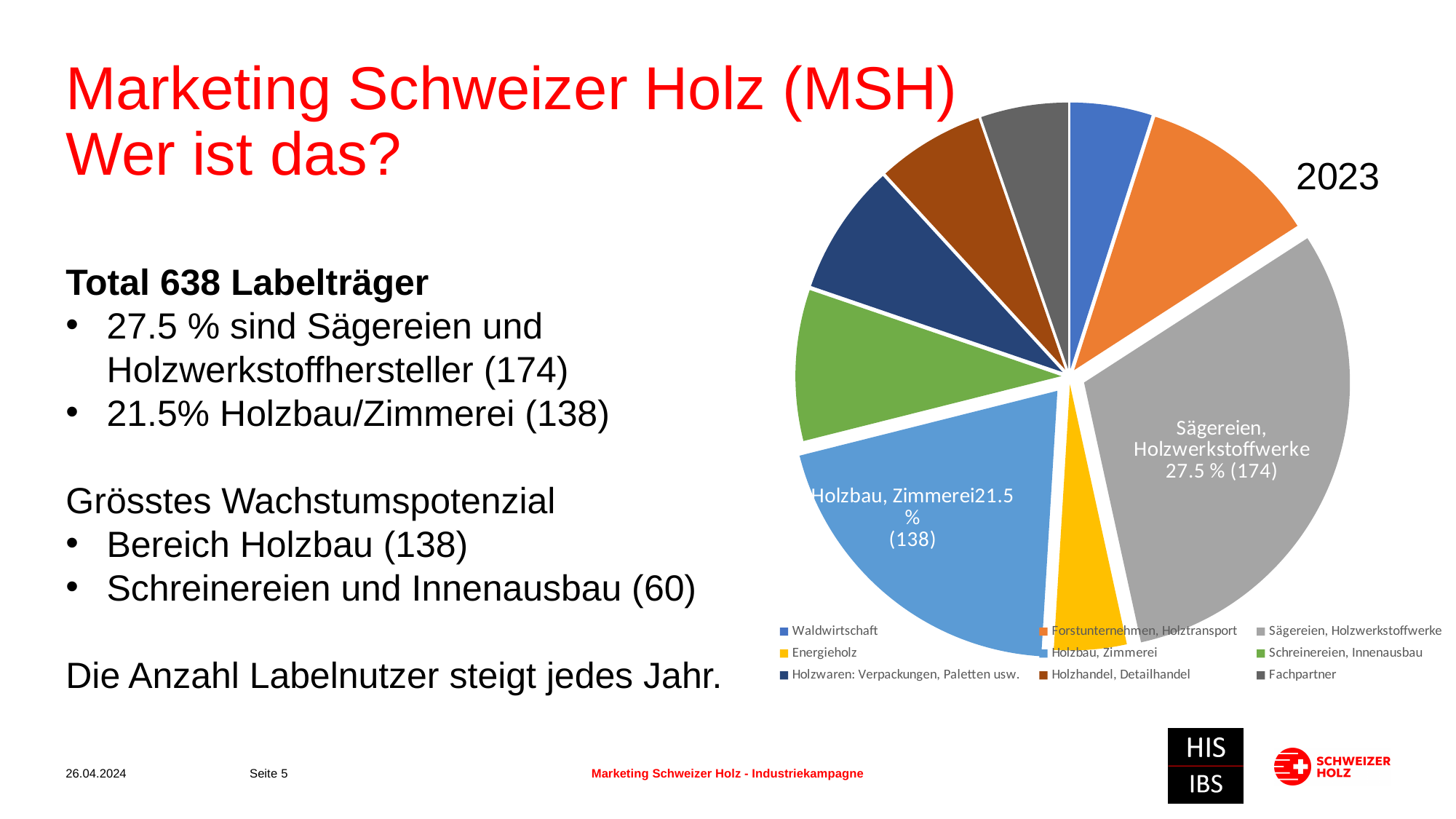
Which category has the largest slice in the pie chart? Sägereien, Holzwerkstoffwerke What value is shown for the Holzbau, Zimmerei slice of the pie chart? 138 What is the difference between the values for Sägereien, Holzwerkstoffwerke and Holzbau, Zimmerei? 36 Which slice is larger: Sägereien, Holzwerkstoffwerke or Holzbau, Zimmerei? Sägereien, Holzwerkstoffwerke What share of the pie does the Holzbau, Zimmerei slice represent? 21.5 % What share of the pie does the Sägereien, Holzwerkstoffwerke slice represent? 27.5 % What value is shown for the Sägereien, Holzwerkstoffwerke slice of the pie chart? 174 What kind of chart is shown on the slide? pie chart Which year is shown next to the pie chart? 2023 What colour represents Energieholz in the pie chart legend? yellow Which slice is larger: Schreinereien, Innenausbau or Energieholz? Schreinereien, Innenausbau How many categories does the legend of the pie chart list? 9